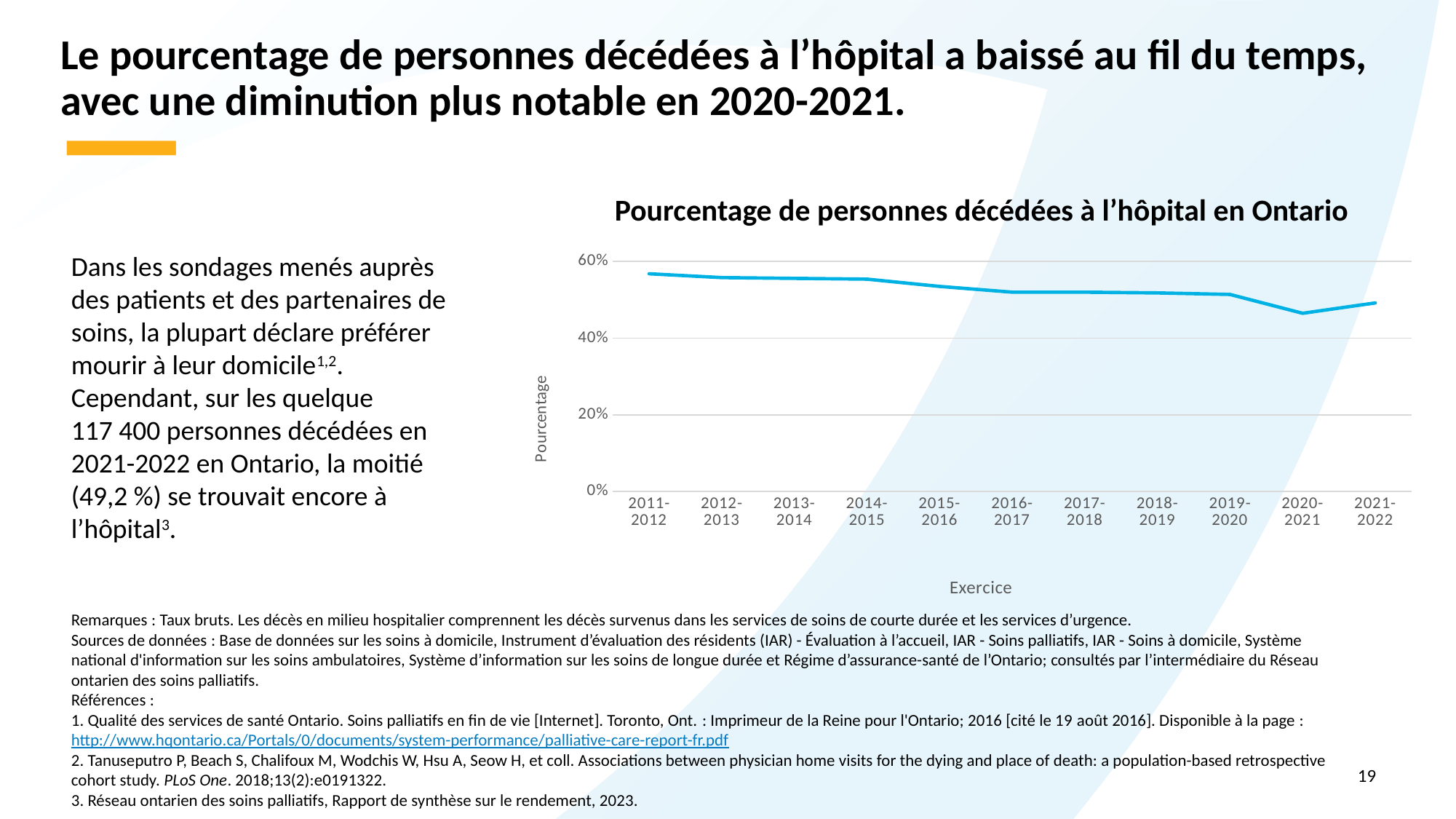
What is the title of the chart? Pourcentage de personnes décédées à l'hôpital en Ontario What kind of chart is shown on the slide? line chart Which fiscal year has the lowest value on the chart? 2020-2021 Is the value for 2021-2022 greater or less than 60%? less Do the values on the chart generally rise or fall from 2011-2012 to 2020-2021? fall Is the value for 2011-2012 greater or less than 60%? less How many fiscal years are plotted on the x axis of the chart? 11 What is the label of the x axis of the chart? Exercice Which is larger, the value for 2011-2012 or the value for 2020-2021? 2011-2012 Is the value for 2011-2012 greater or less than 40%? greater Which is larger, the value for 2020-2021 or the value for 2021-2022? 2021-2022